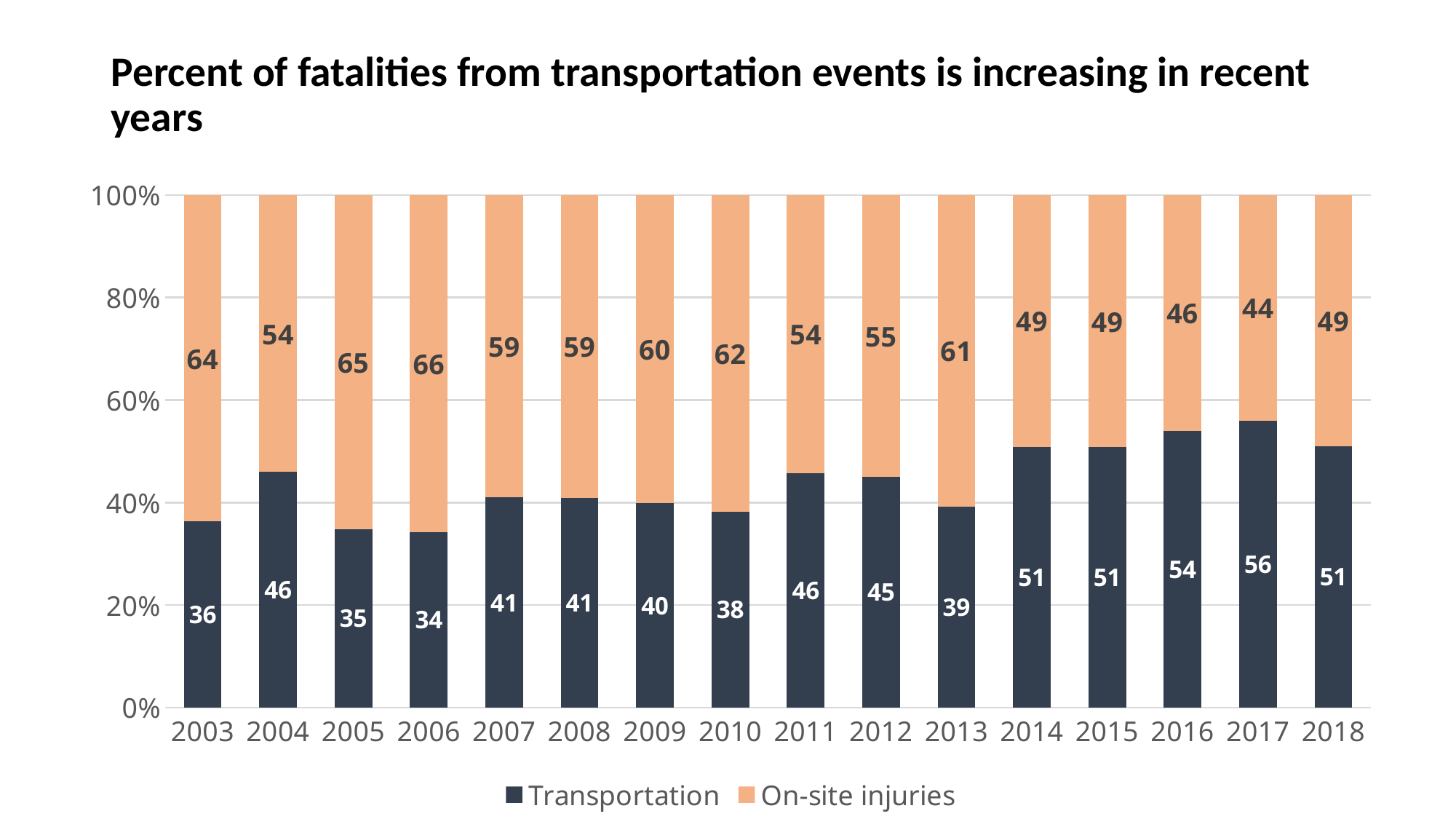
Do the Transportation values generally rise or fall from 2013 to 2017? Rise How many years are shown on the x axis? 16 What is the difference between the Transportation values for 2017 and 2003? 20 What is the Transportation value for 2011? 46 What kind of chart is shown on the slide? Stacked bar chart Which year has the highest Transportation value? 2017 What is the title of the chart? Percent of fatalities from transportation events is increasing in recent years How many series does the legend list? 2 Which is larger, the On-site injuries value for 2006 or for 2013? 2006 Which year has the lowest Transportation value? 2006 What is the On-site injuries value for 2017? 44 What is the Transportation value for 2003? 36